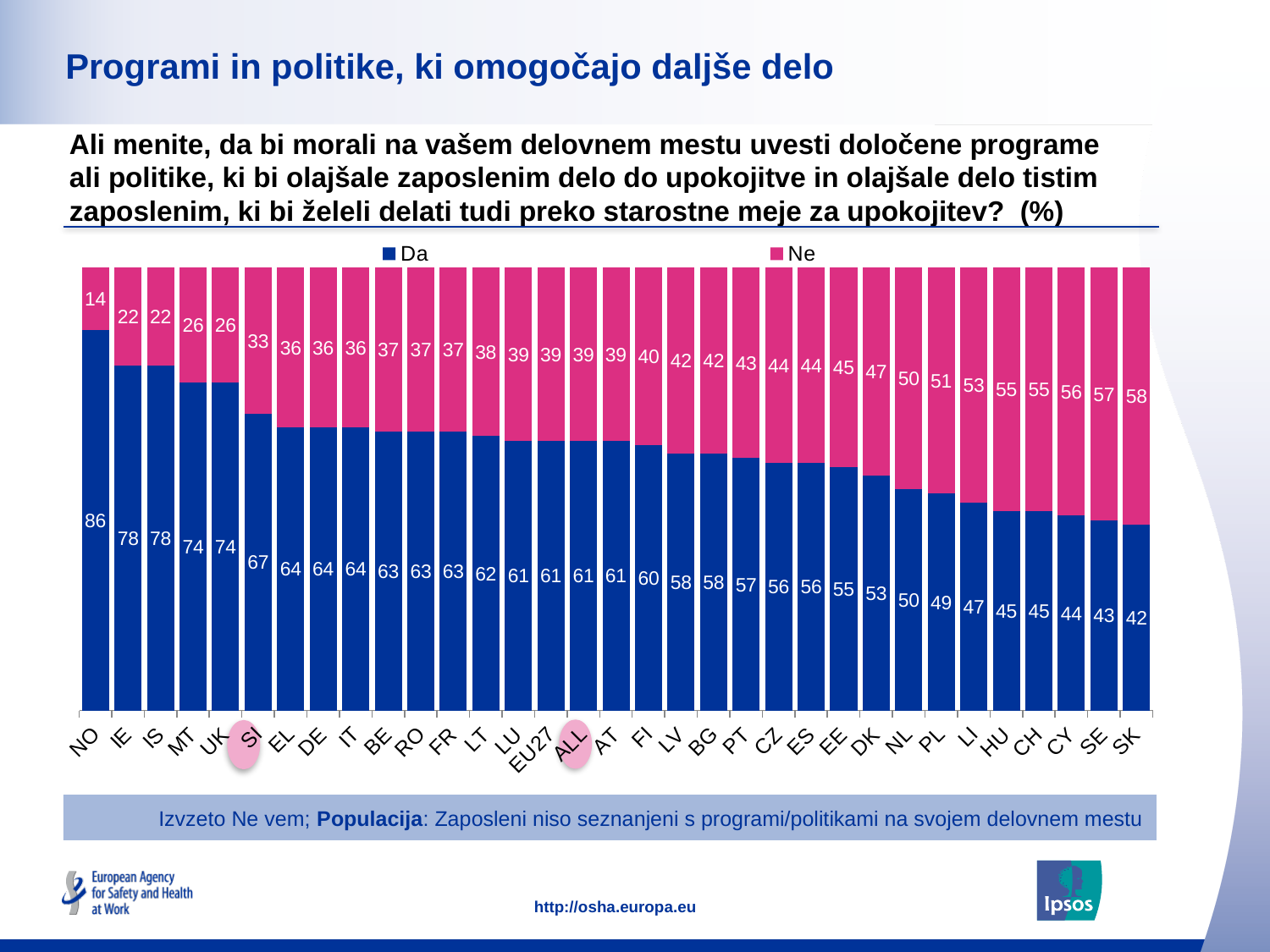
What is the 'Da' value for NO? 86 Do the 'Da' values rise or fall from left to right along the x axis? Fall What is the difference between the 'Da' values for NO and SK? 44 What is the 'Ne' value for SK? 58 Which is larger, the 'Da' value for DK or the 'Da' value for NL? DK What is the 'Da' value for EU27? 61 How many countries/categories are shown on the x axis? 33 What kind of chart is shown on the slide? Stacked bar chart What is the 'Ne' value for SI? 33 How many series does the legend list? 2 Which country has the lowest 'Da' value? SK Which country has the highest 'Da' value? NO